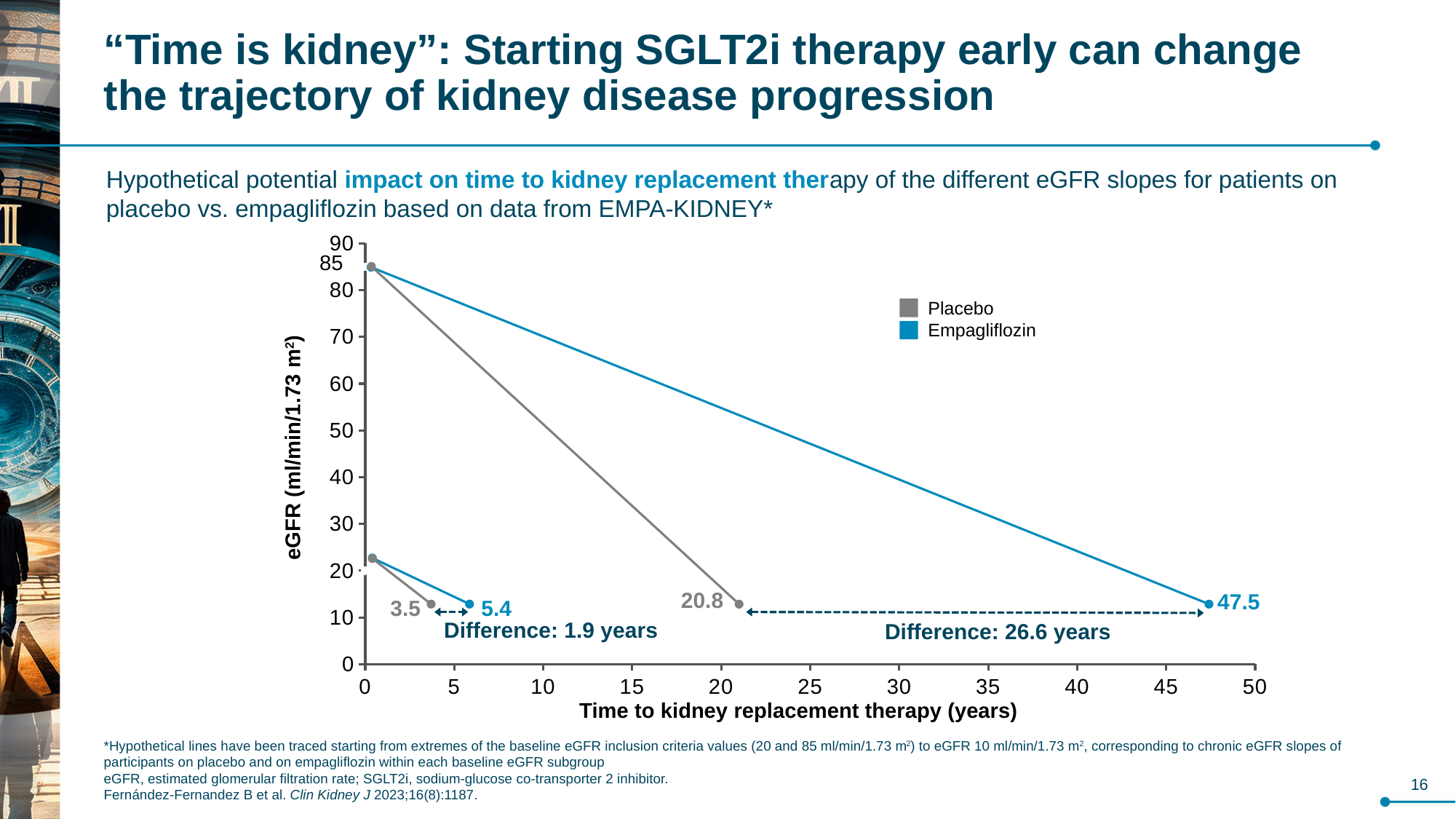
What is the difference in years between the Empagliflozin and Placebo endpoints for the lines starting at the lower baseline eGFR? 1.9 years How many series does the legend list? 2 Which series is shown in blue in the legend? Empagliflozin What is the labelled time to kidney replacement therapy for Placebo starting from the lower baseline eGFR? 3.5 What is the labelled time to kidney replacement therapy for Placebo starting from a baseline eGFR of 85? 20.8 What is the x-axis title of the chart? Time to kidney replacement therapy (years) What is the labelled time to kidney replacement therapy for Empagliflozin starting from the lower baseline eGFR? 5.4 What is the labelled time to kidney replacement therapy for Empagliflozin starting from a baseline eGFR of 85? 47.5 Which series reaches kidney replacement therapy later when starting from eGFR 85, Placebo or Empagliflozin? Empagliflozin What type of chart is shown on the slide? line chart What is the difference in years between the Empagliflozin and Placebo endpoints for the lines starting at eGFR 85? 26.6 years Do the eGFR values rise or fall along the x axis for both series? fall